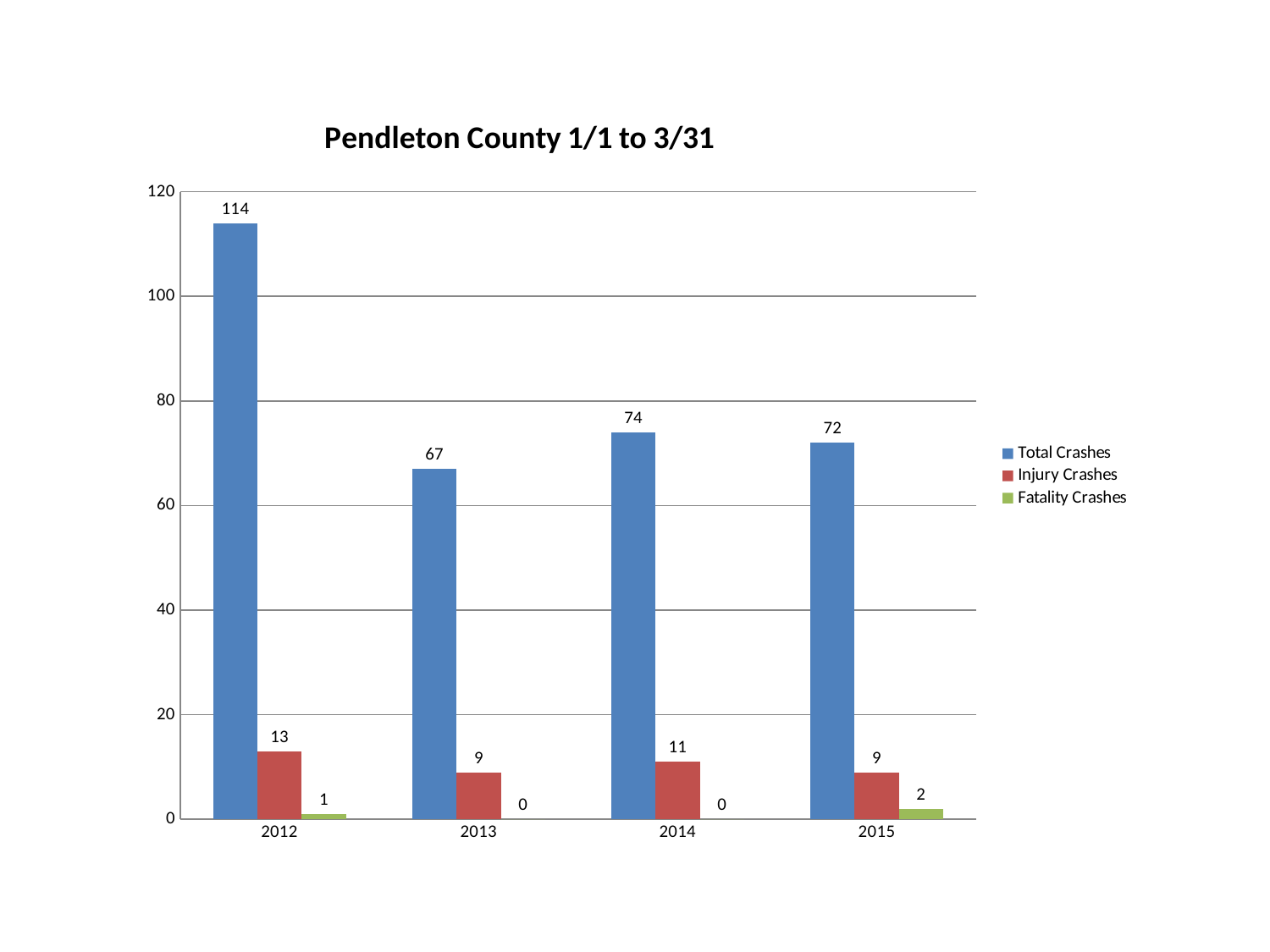
What is the difference between Total Crashes in 2012 and 2013? 47 Which year has the lowest Total Crashes? 2013 How many series does the legend list? 3 What is the value for Fatality Crashes in 2015? 2 Is the value for Total Crashes in 2014 greater or less than 80? less How many years are shown on the x axis? 4 What is the value for Injury Crashes in 2014? 11 What is the value for Total Crashes in 2012? 114 What is the title of the chart? Pendleton County 1/1 to 3/31 Which year has the highest Total Crashes? 2012 Which is larger, Injury Crashes in 2012 or Injury Crashes in 2015? Injury Crashes in 2012 What kind of chart is shown on the slide? bar chart